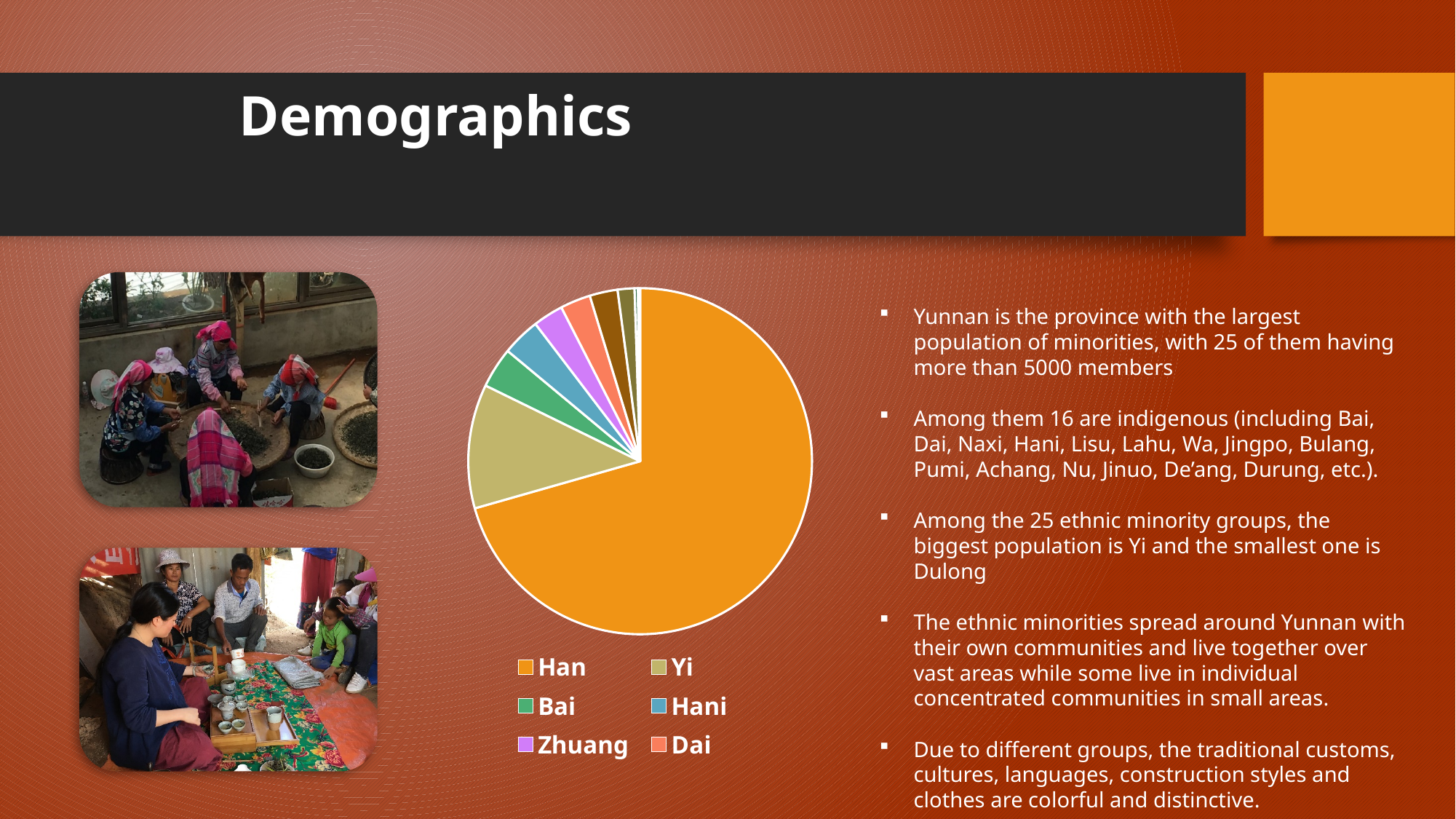
Which group in the legend is shown in green? Bai Which slice is larger in the pie chart, Yi or Hani? Yi What colour is the Han slice in the pie chart? orange Which slice is larger in the pie chart, Yi or Bai? Yi Which group has the largest slice in the pie chart? Han How many groups are listed in the chart's legend? 6 Which slice is larger in the pie chart, Han or Yi? Han What kind of chart is shown on the slide? pie chart Among the groups named in the legend, which has the second-largest slice? Yi